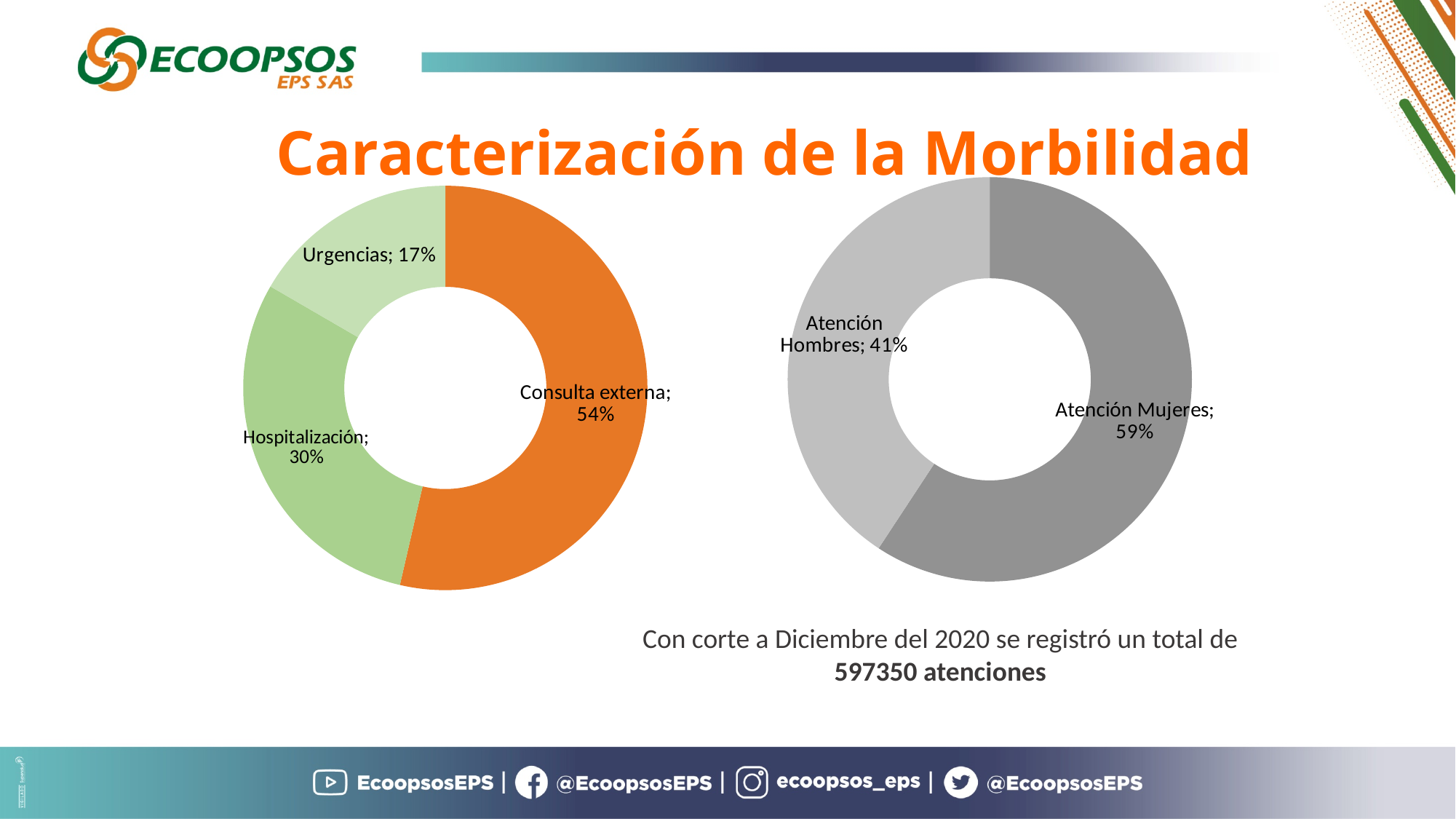
In the right chart, what is the difference between Atención Mujeres and Atención Hombres? 18% In the left chart, what is the difference between Consulta externa and Hospitalización? 24% In the left chart, what is the value for Urgencias? 17% In the left chart, what is the value for Hospitalización? 30% In the right chart, which is larger, Atención Mujeres or Atención Hombres? Atención Mujeres What kind of chart is the left chart? Doughnut chart In the right chart, what is the value for Atención Mujeres? 59% In the left chart, what is the value for Consulta externa? 54% In the right chart, what is the value for Atención Hombres? 41% In the left chart, how many categories are shown? 3 In the left chart, which category has the largest share? Consulta externa In the left chart, which category has the smallest share? Urgencias